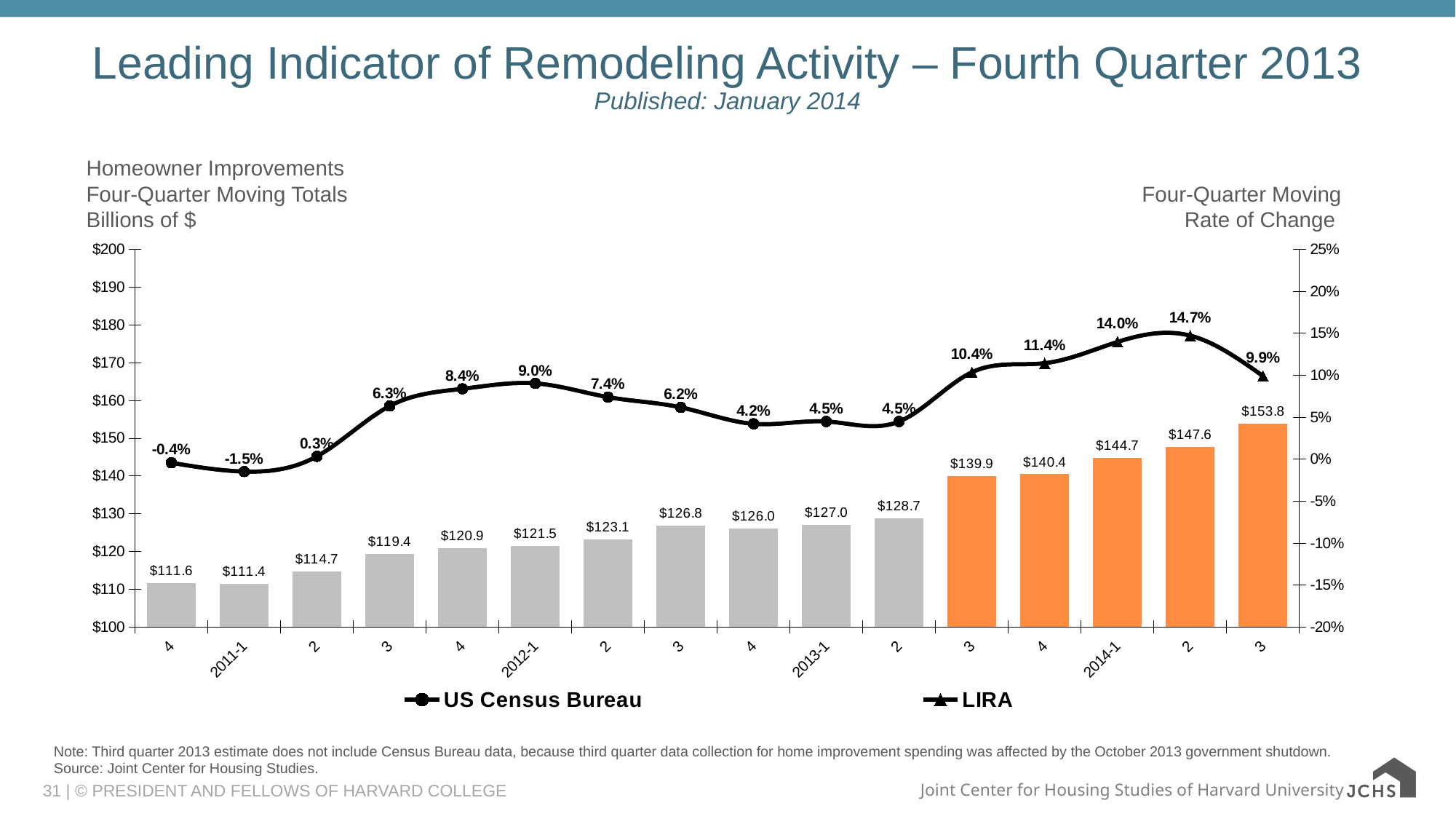
What is the four-quarter moving total for 2014-1? $144.7 How many series does the legend list? 2 What is the highest four-quarter moving rate of change shown on the line? 14.7% What is the value of the highest bar in the chart? $153.8 What is the four-quarter moving rate of change shown for 2012-1? 9.0% How many bars are plotted in the chart? 16 What is the difference between the last bar ($153.8) and the bar before it ($147.6)? $6.2 What is the lowest four-quarter moving rate of change shown on the line? -1.5% What kind of chart is shown on the slide? Combination bar and line chart Do the bar values generally rise or fall from left to right? Rise Which is larger, the bar for quarter 2 of 2012 or the bar for quarter 3 of 2012? Quarter 3 of 2012 ($126.8) What is the value of the bar for quarter 2 of 2013? $128.7